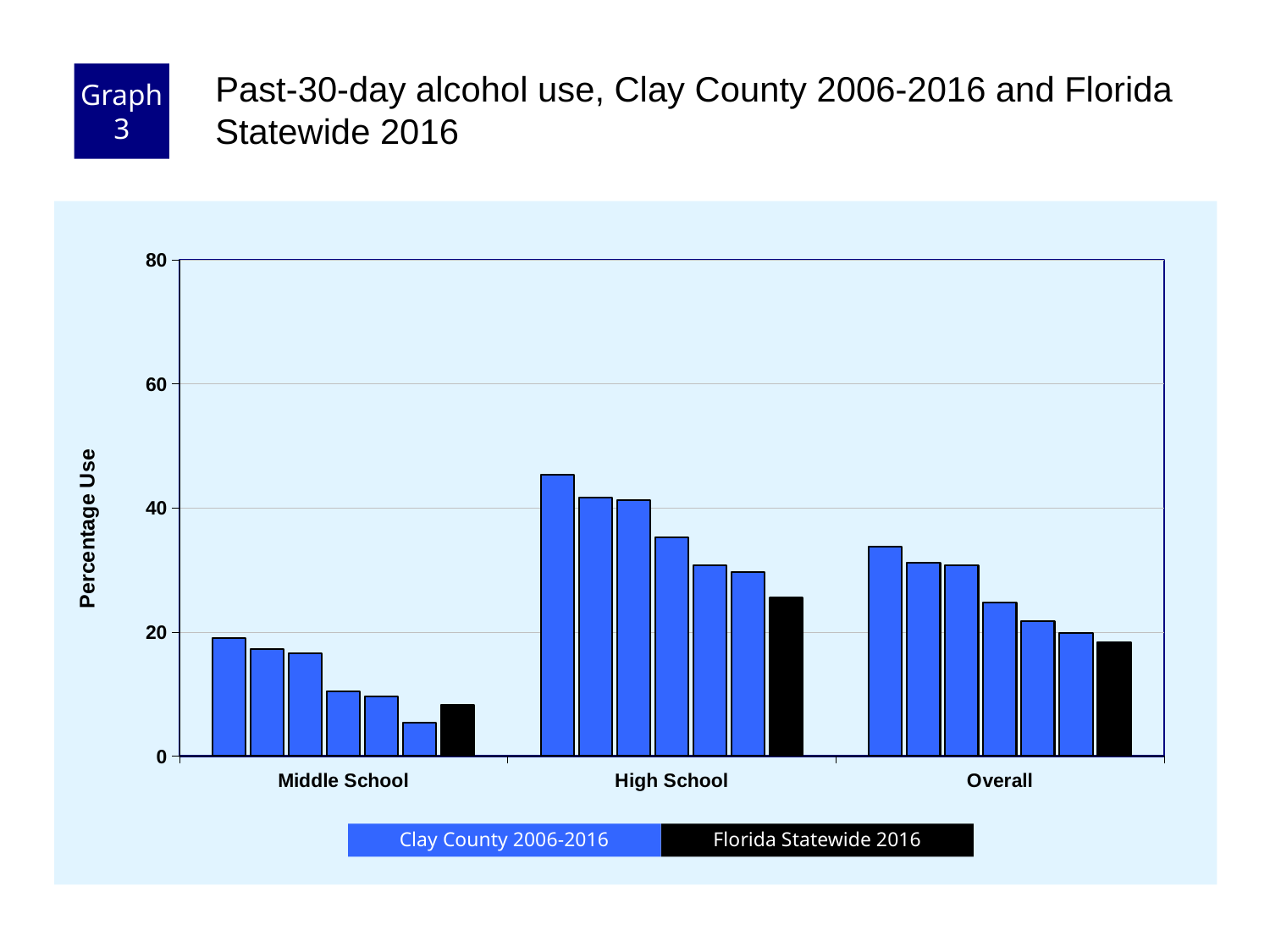
Which category has the lowest bars overall? Middle School Within each category, do the Clay County 2006-2016 bars generally rise or fall from left to right? fall How many series does the legend list? 2 Is the Florida Statewide 2016 value for Middle School greater or less than 20? less How many categories are shown along the x axis? 3 What kind of chart is shown on the slide? bar chart What is the label on the y axis? Percentage Use Is the tallest Clay County bar for Overall greater or less than 40? less Is the Florida Statewide 2016 value for High School greater or less than 20? greater Which category has the highest bars overall? High School Which is larger, the Florida Statewide 2016 value for High School or for Middle School? High School